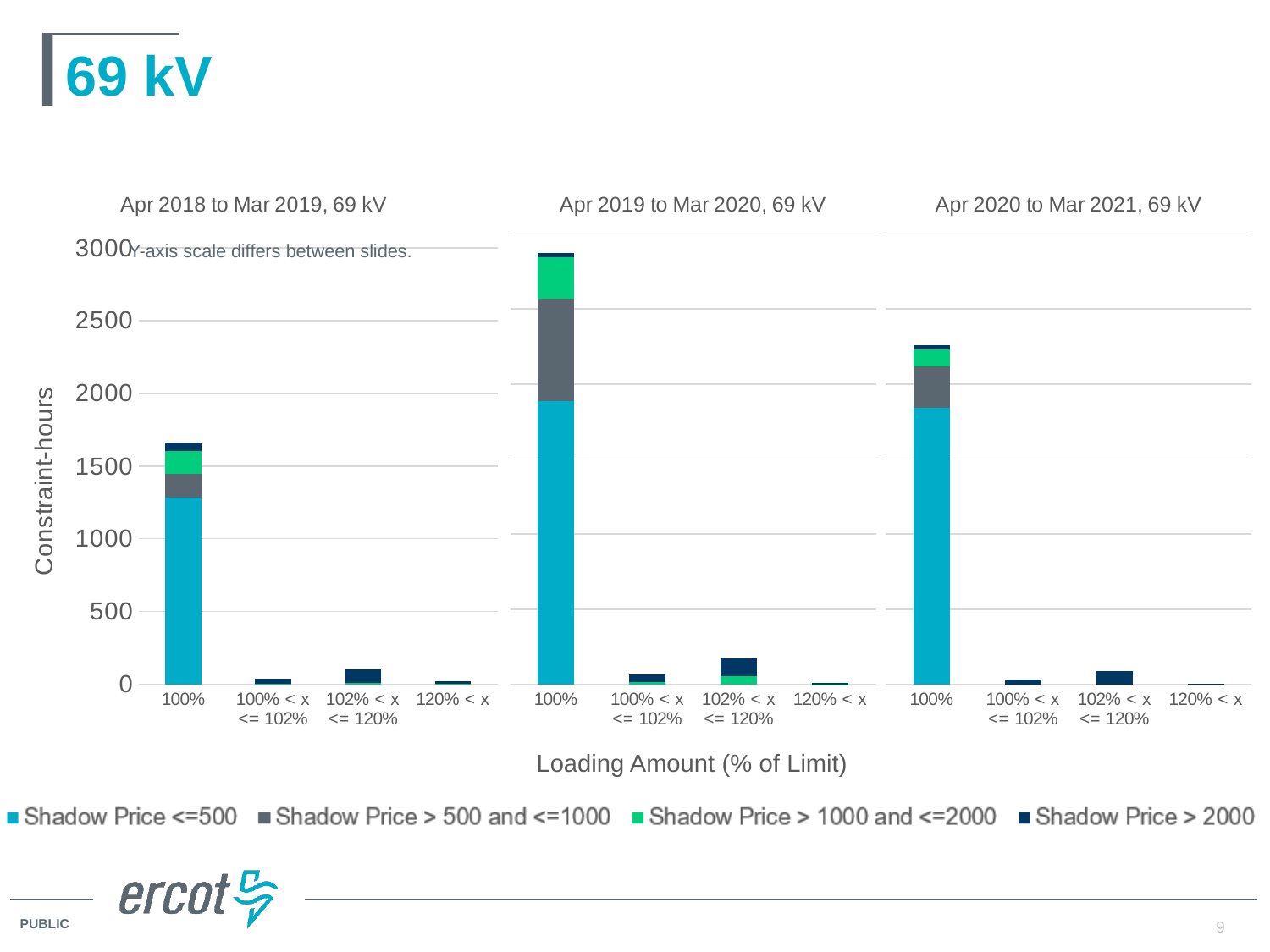
In the chart titled 'Apr 2019 to Mar 2020, 69 kV', which is taller: the bar for '100% < x <= 102%' or the bar for '102% < x <= 120%'? 102% < x <= 120% In the chart titled 'Apr 2020 to Mar 2021, 69 kV', is the total of the stacked bar for 100% greater or less than 2000? greater What is the label on the y axis of the charts? Constraint-hours In the chart titled 'Apr 2018 to Mar 2019, 69 kV', which loading amount category has the tallest stacked bar? 100% In the chart titled 'Apr 2019 to Mar 2020, 69 kV', is the total of the stacked bar for 100% greater or less than 2500? greater In the chart titled 'Apr 2018 to Mar 2019, 69 kV', is the 'Shadow Price <=500' segment of the 100% bar greater or less than 1000? greater Which of the three charts has the tallest stacked bar for the 100% category? Apr 2019 to Mar 2020, 69 kV What kind of chart is shown on the slide? stacked bar chart In the chart titled 'Apr 2018 to Mar 2019, 69 kV', which loading amount category has the shortest stacked bar? 120% < x In the chart titled 'Apr 2018 to Mar 2019, 69 kV', how many loading amount categories are shown on the x axis? 4 How many series does the legend list? 4